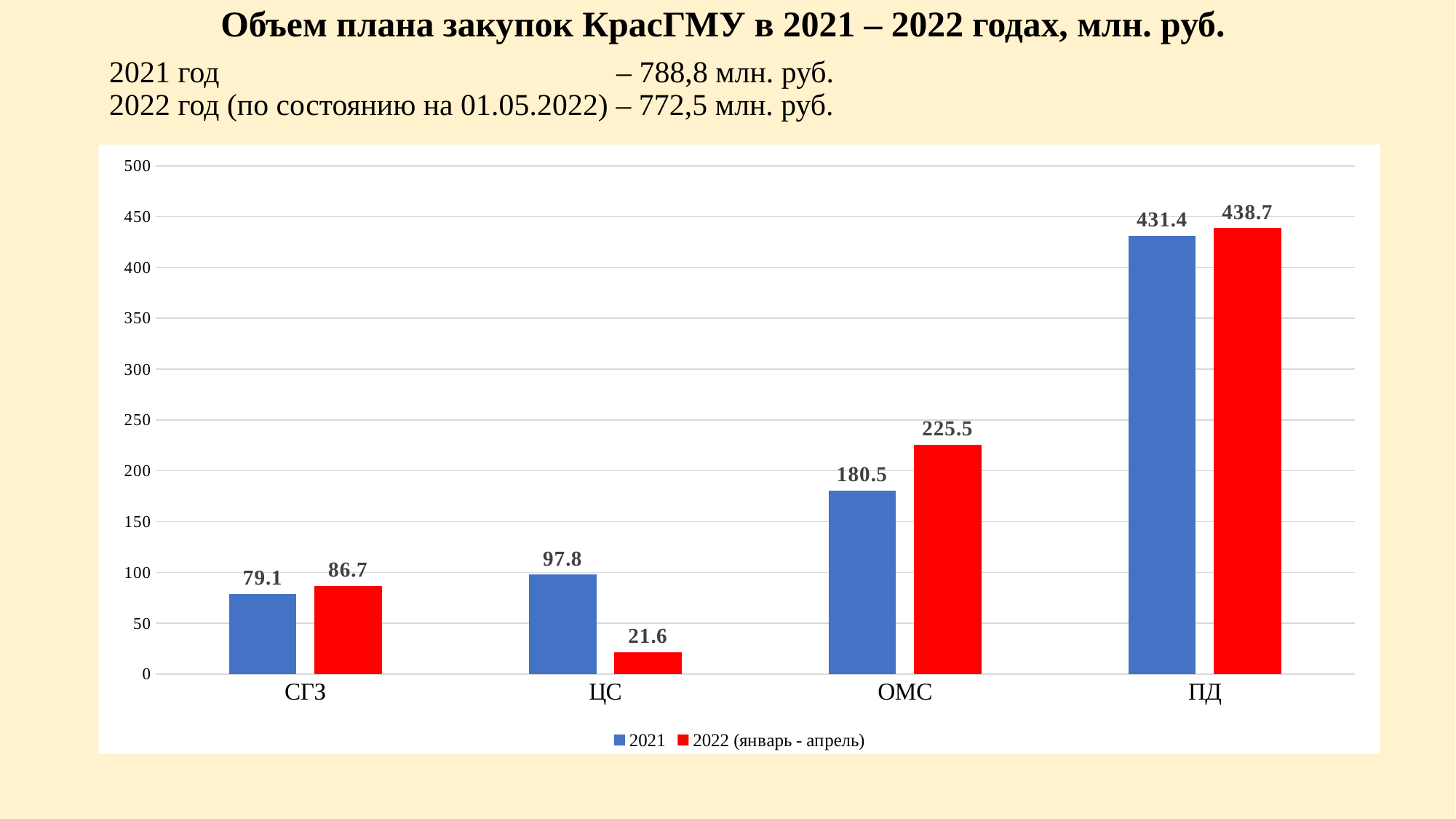
What is the difference between the 2022 (январь - апрель) and 2021 values for ОМС? 45 What is the 2022 (январь - апрель) value for ПД? 438.7 What is the 2022 (январь - апрель) value for ЦС? 21.6 What kind of chart is shown on the slide? bar chart Which category has the highest 2021 value? ПД Which is larger for СГЗ: the 2021 value or the 2022 (январь - апрель) value? 2022 (январь - апрель) How many categories are shown on the x axis? 4 Which category has the lowest 2022 (январь - апрель) value? ЦС What is the 2021 value for ОМС? 180.5 What is the difference between the 2021 and 2022 (январь - апрель) values for ЦС? 76.2 How many series does the legend list? 2 What colour are the bars for the 2021 series? blue